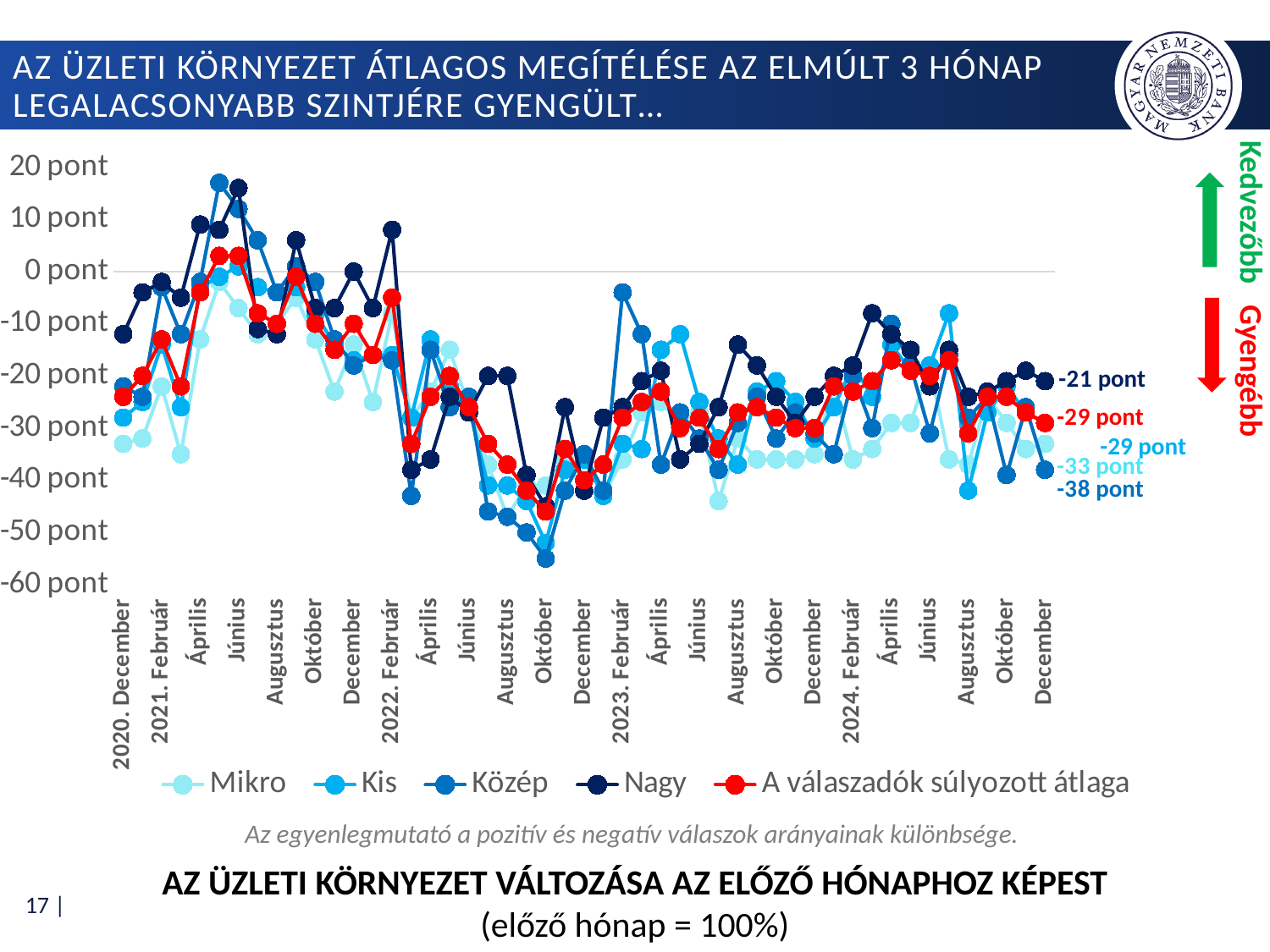
How many series does the legend list? 5 What kind of chart is shown on the slide? line chart What is the value of the Nagy series at the end of the chart (2024 December)? -21 pont What is the value of 'A válaszadók súlyozott átlaga' at the end of the chart (2024 December)? -29 pont Which series has the highest value at the end of the chart (2024 December)? Nagy Does 'A válaszadók súlyozott átlaga' rise or fall between 2021 Június and 2022 Október? fall Is the value of the Nagy series in 2021 Június greater or less than 10 pont? greater Is the value of 'A válaszadók súlyozott átlaga' in 2022 Október greater or less than -40 pont? less What is the difference between the Nagy series and 'A válaszadók súlyozott átlaga' at the end of the chart (2024 December)? 8 pont At the end of the chart (2024 December), which is larger: the Nagy series or the Mikro series? Nagy What is the value of the Mikro series at the end of the chart (2024 December)? -33 pont Which legend entry is drawn in red? A válaszadók súlyozott átlaga